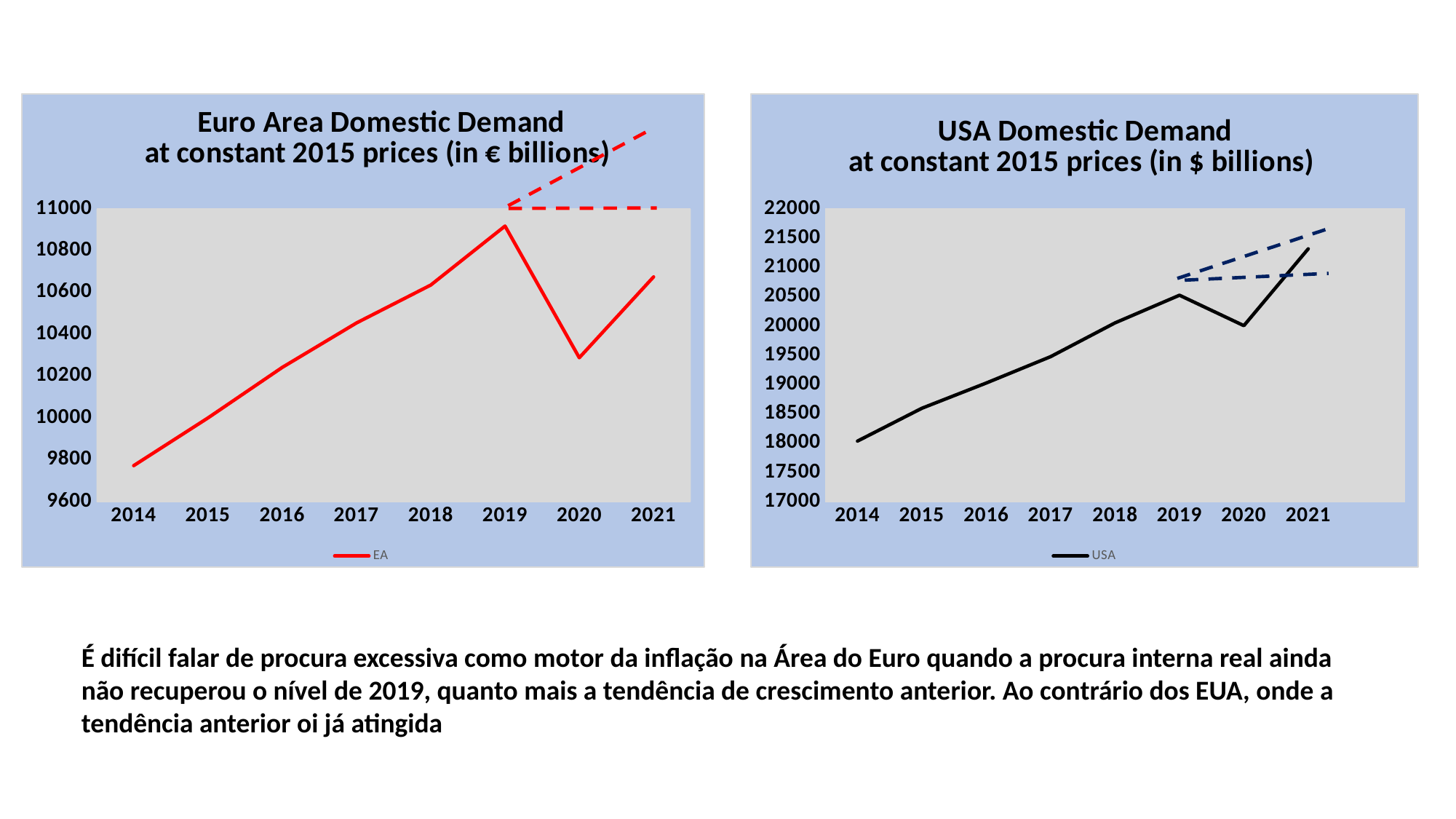
What kind of chart is the Euro Area Domestic Demand chart? line chart In the Euro Area Domestic Demand chart, which year has the lowest value? 2014 In the USA Domestic Demand chart, what is the name of the series in the legend? USA How many years are shown on the x axis of the USA Domestic Demand chart? 8 In the USA Domestic Demand chart, is the value for 2021 greater or less than 21000? greater In the USA Domestic Demand chart, which year has the lowest value? 2014 How many series does the legend of the Euro Area Domestic Demand chart list? 1 In the Euro Area Domestic Demand chart, which year has the highest value? 2019 In the Euro Area Domestic Demand chart, is the value for 2014 greater or less than 10000? less In the USA Domestic Demand chart, is the value for 2020 greater or less than 20500? less In the Euro Area Domestic Demand chart, which is larger, the value for 2019 or the value for 2021? 2019 In the USA Domestic Demand chart, which year has the highest value? 2021